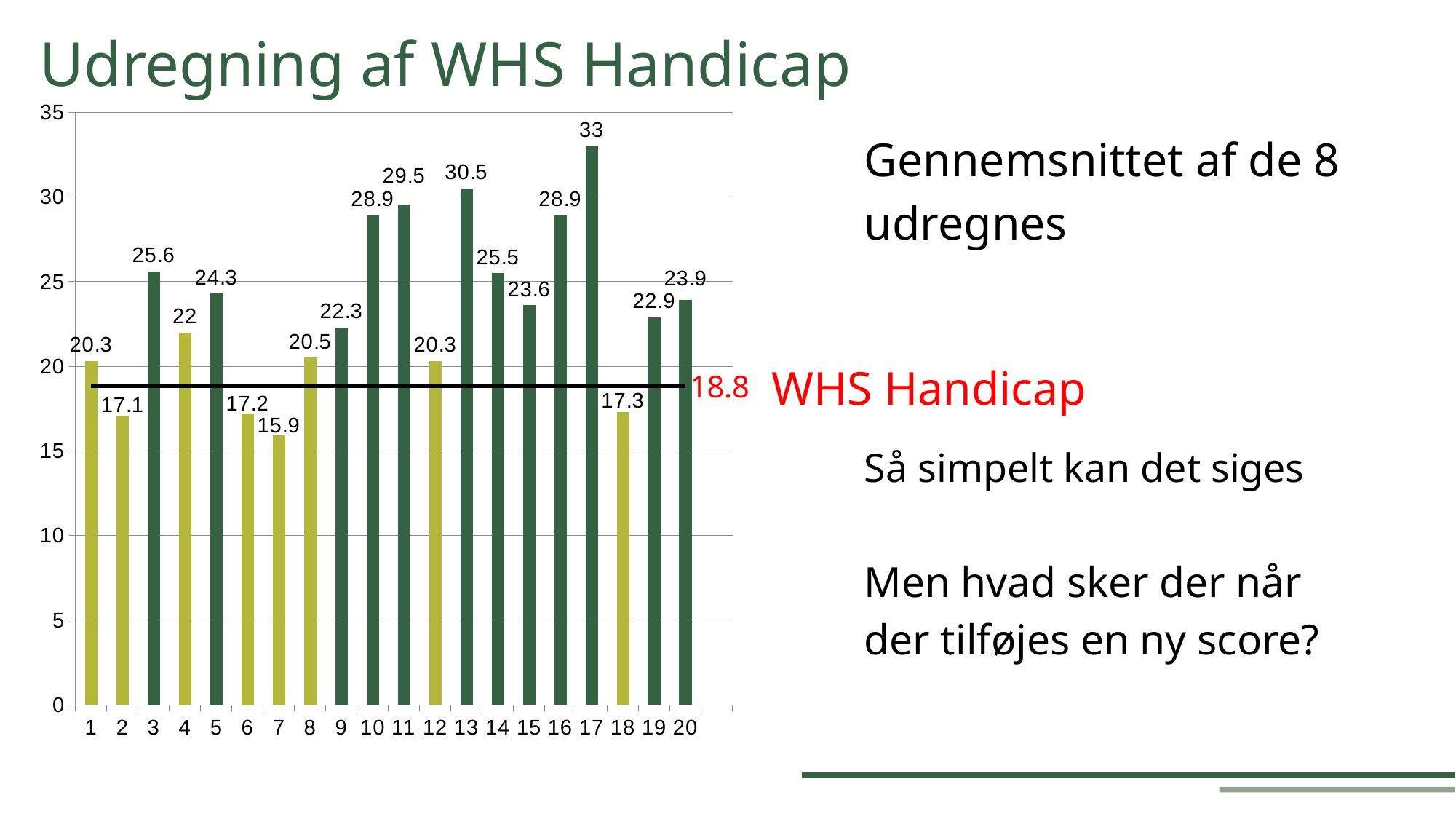
What type of chart is shown on the slide? bar chart What is the difference between the values of bar 13 and bar 4? 8.5 What is the value of bar 17? 33 How many bars are coloured light green (yellow-green) rather than dark green? 8 What is the value of bar 11? 29.5 Which category has the lowest value? 7 Which is larger, the value of bar 3 or the value of bar 14? bar 3 Which category has the highest value? 17 What is the value of bar 7? 15.9 Is the value for bar 10 greater or less than 25? greater What value is marked by the horizontal line labelled WHS Handicap? 18.8 How many bars (categories) are plotted in the chart? 20